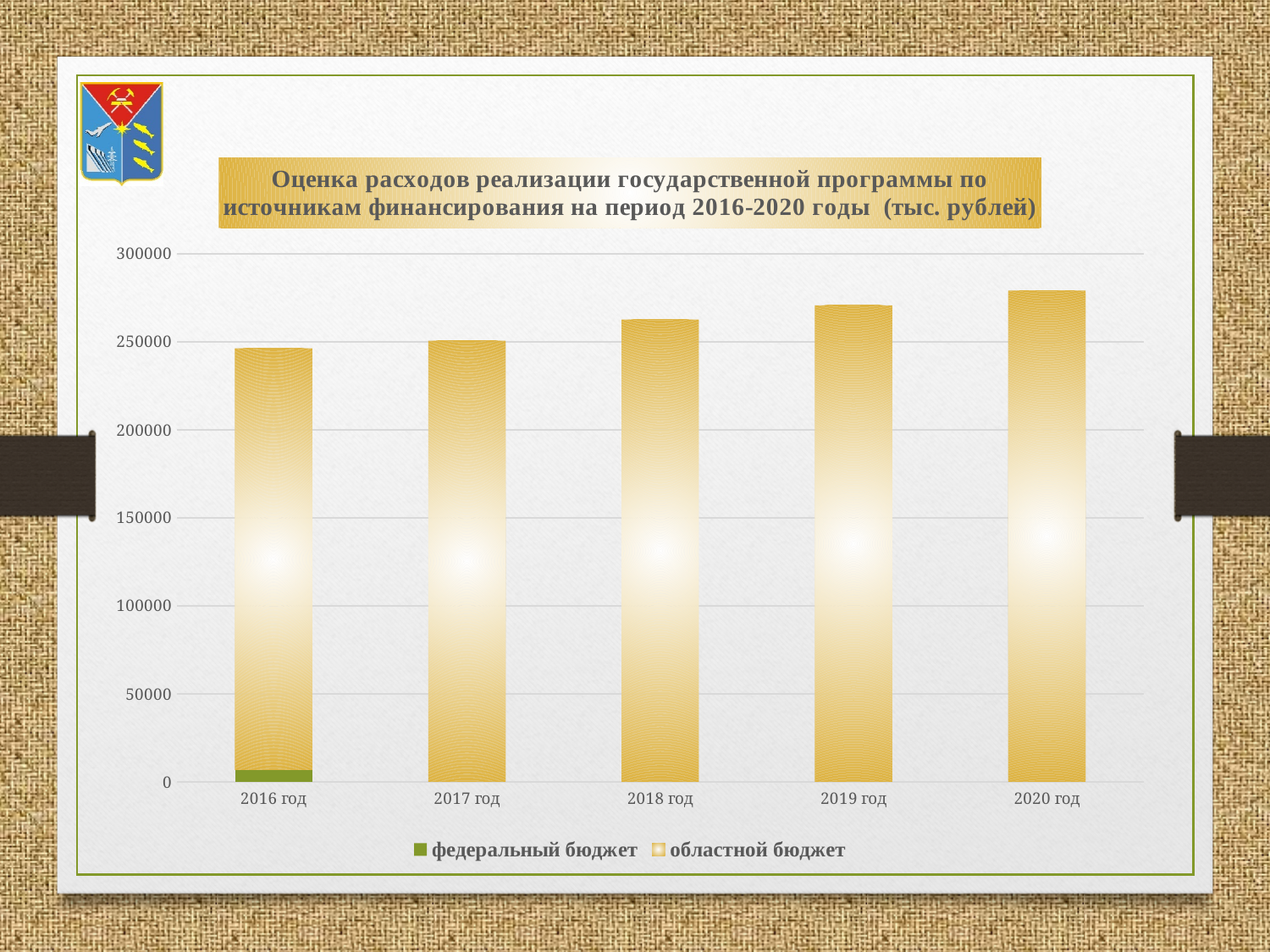
In which year does the bar include a федеральный бюджет segment? 2016 год Which series is shown in green in the legend? федеральный бюджет Which year has the lowest total bar? 2016 год What kind of chart is shown on the slide? bar chart How many series does the legend list? 2 Which year has the highest total bar? 2020 год Is the total value for 2019 год greater or less than 300000? less Do the total bar heights rise or fall from 2016 год to 2020 год? rise Is the total value for 2016 год greater or less than 250000? less Is the total value for 2020 год greater or less than 250000? greater How many years (categories) are shown on the x axis? 5 Which is larger, the total bar for 2018 год or for 2016 год? 2018 год